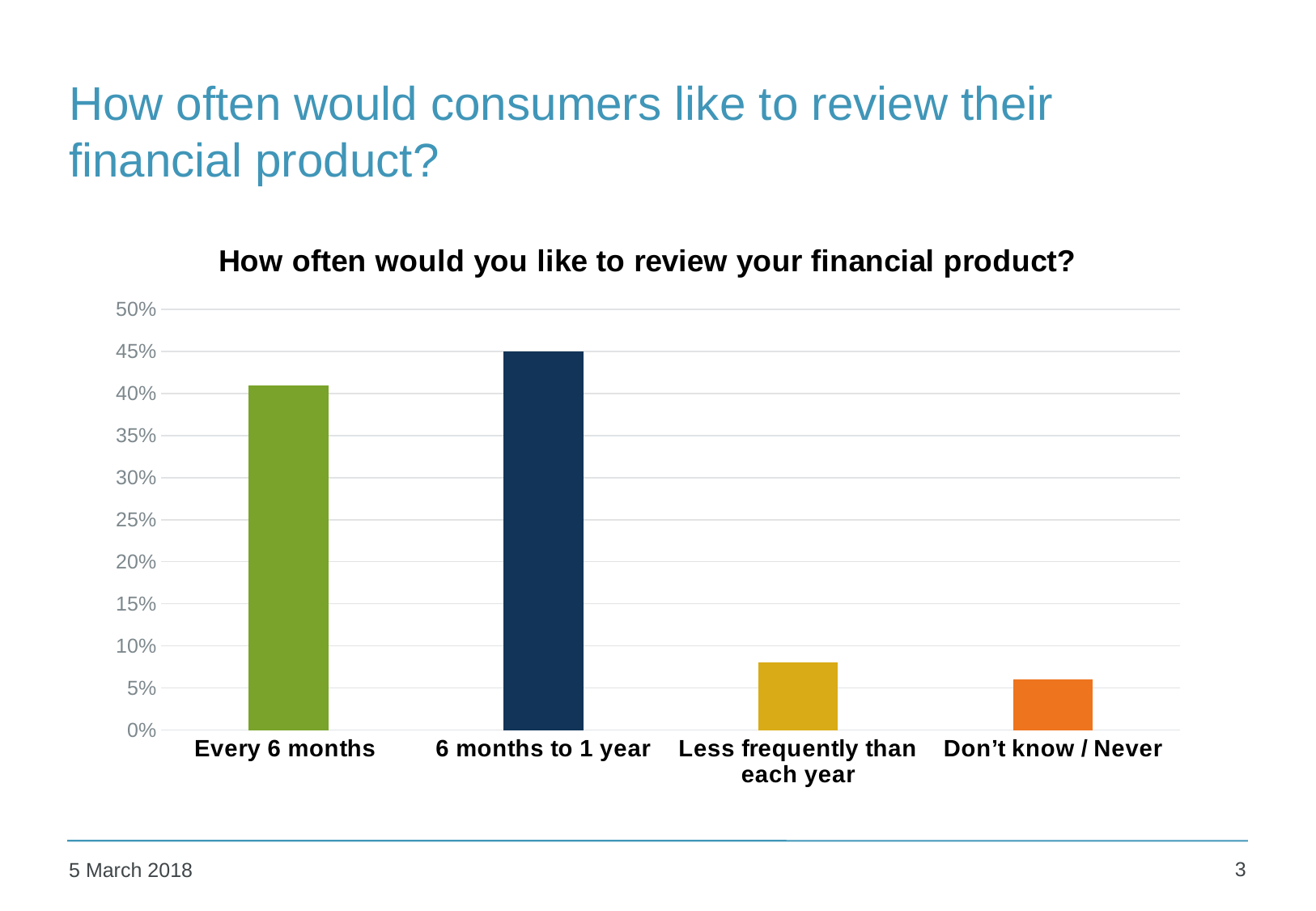
What colour is the bar for 'Every 6 months'? green What kind of chart is shown on the slide? bar chart Which is larger: the value for 'Every 6 months' or the value for '6 months to 1 year'? 6 months to 1 year How many categories are shown on the x axis of the chart? 4 Is the value for 'Every 6 months' greater or less than 35%? greater Which category has the highest value in the chart? 6 months to 1 year Which category has the lowest value in the chart? Don't know / Never What is the value for '6 months to 1 year'? 45% Which is larger: the value for 'Less frequently than each year' or the value for 'Every 6 months'? Every 6 months What is the title of the chart? How often would you like to review your financial product? Is the value for 'Don't know / Never' greater or less than 10%? less Is the value for 'Less frequently than each year' greater or less than 10%? less